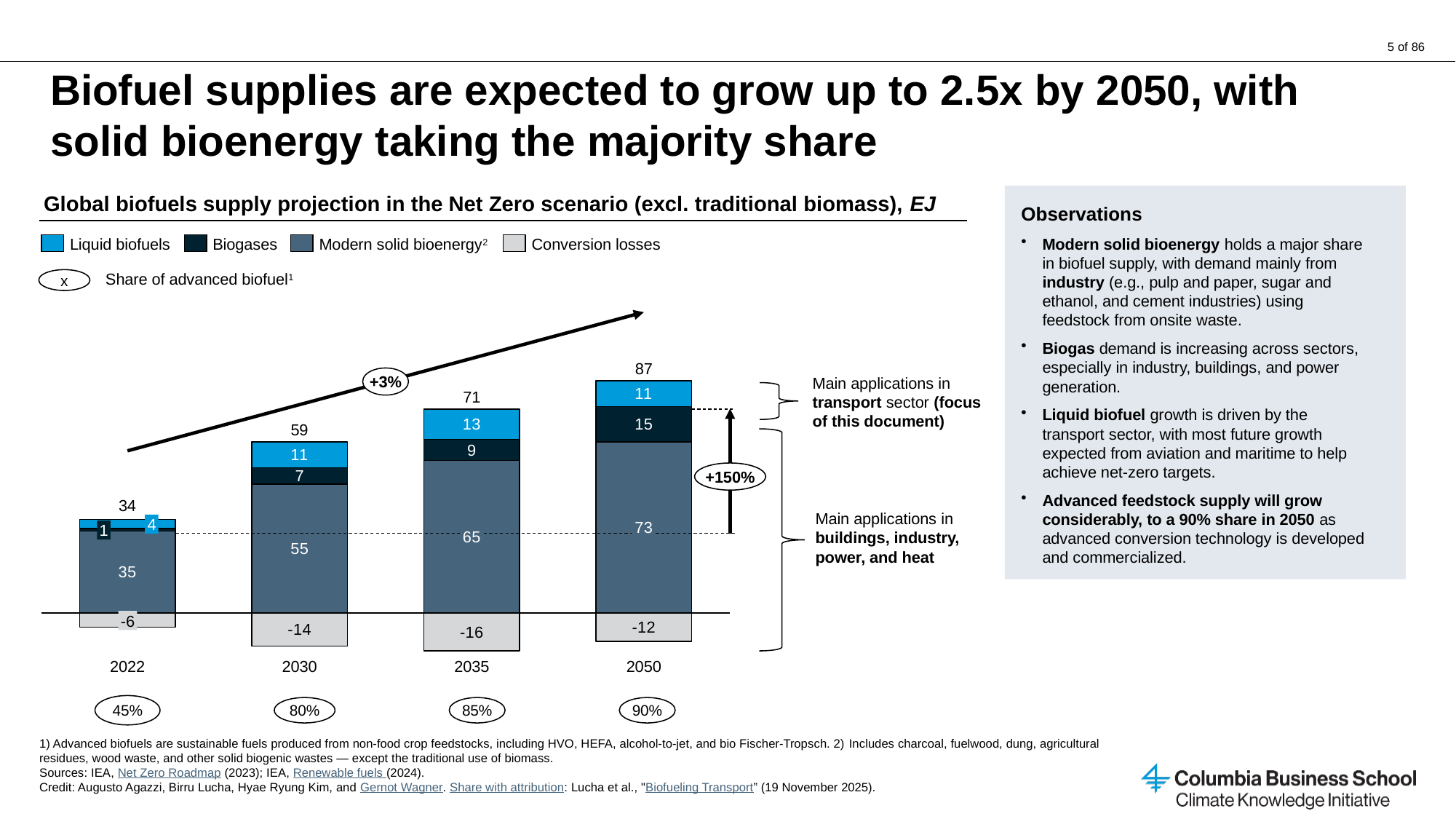
What is the value for Conversion losses in 2022? -6 How many years are shown on the x axis of the chart? 4 Which year has the lowest value for Liquid biofuels? 2022 What is the value for Biogases in 2030? 7 What is the difference between the Modern solid bioenergy values for 2050 and 2022? 38 What is the total global biofuels supply shown for 2050? 87 Which is larger, the Liquid biofuels value in 2035 or in 2050? 2035 What kind of chart is used to show the global biofuels supply projection? Stacked bar chart What is the value for Modern solid bioenergy in 2035? 65 How many series does the chart legend list? 4 Which year has the highest total biofuels supply? 2050 What share of advanced biofuel is shown for 2035? 85%